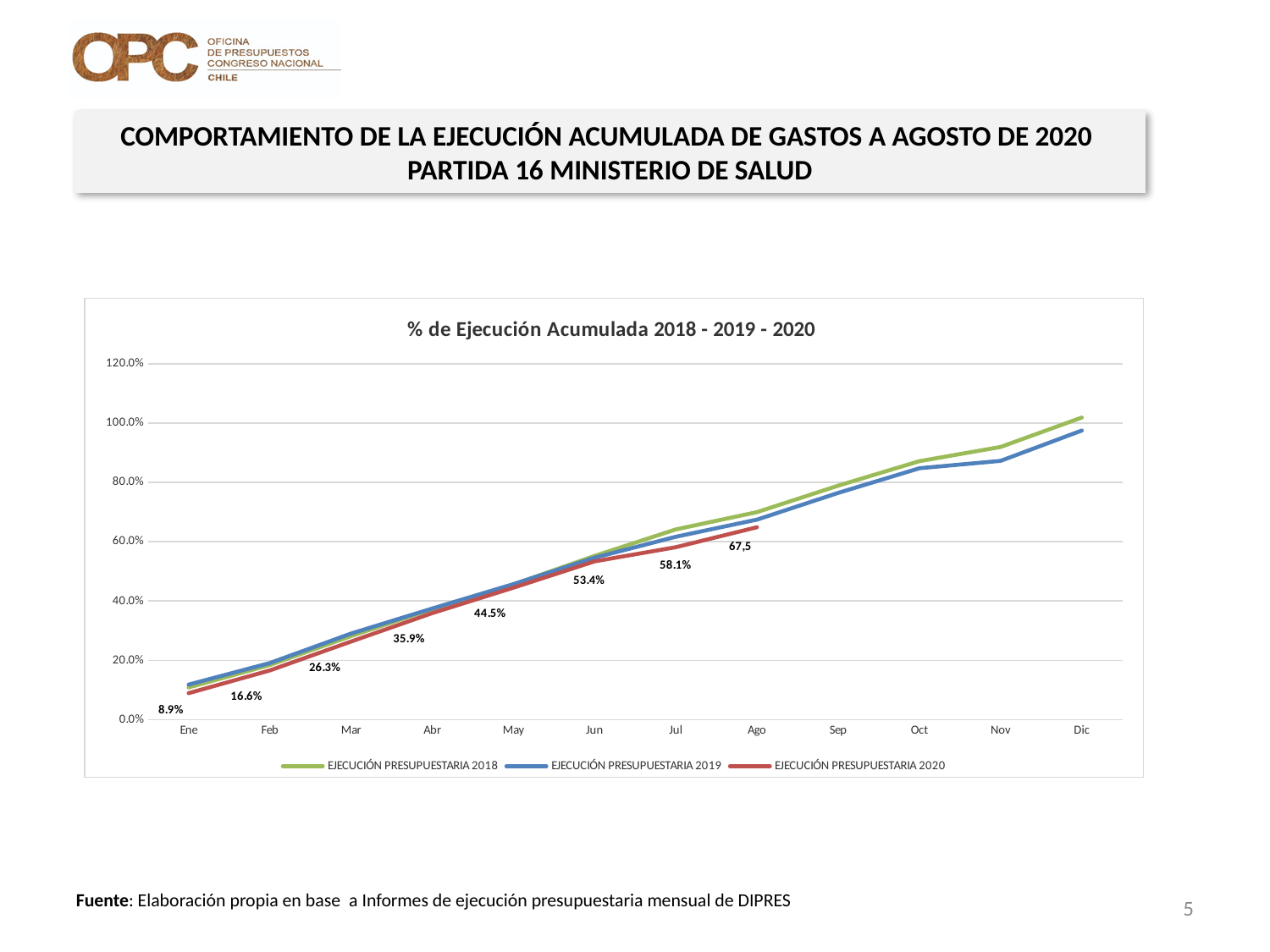
How many series does the legend list? 3 What is the value for EJECUCIÓN PRESUPUESTARIA 2020 in Jul? 58.1% What is the data label shown for EJECUCIÓN PRESUPUESTARIA 2020 in Ago? 67,5 What is the title of the chart? % de Ejecución Acumulada 2018 - 2019 - 2020 Is the value for EJECUCIÓN PRESUPUESTARIA 2019 in Nov greater or less than 80.0%? greater What kind of chart is shown on the slide? line chart What is the difference between the EJECUCIÓN PRESUPUESTARIA 2020 values for Jun and May? 8.9% Does the EJECUCIÓN PRESUPUESTARIA 2020 line rise or fall from Ene to Ago? rise What is the value for EJECUCIÓN PRESUPUESTARIA 2020 in Abr? 35.9% How many months are shown on the x axis? 12 Which is larger in Dic, EJECUCIÓN PRESUPUESTARIA 2018 or EJECUCIÓN PRESUPUESTARIA 2019? EJECUCIÓN PRESUPUESTARIA 2018 What is the value for EJECUCIÓN PRESUPUESTARIA 2020 in Ene? 8.9%